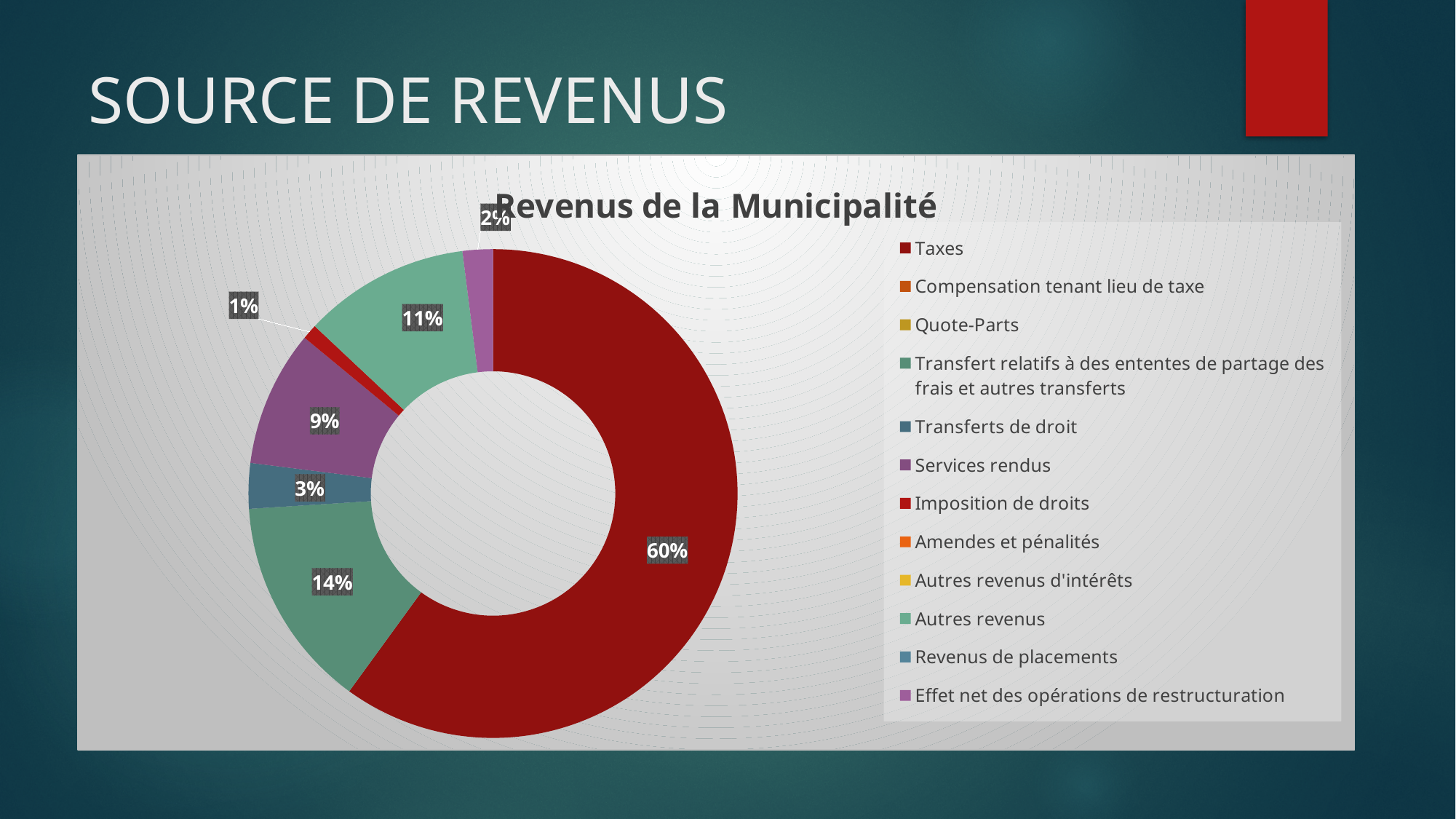
How many percentage points larger is the Taxes share than the Transfert relatifs à des ententes de partage des frais et autres transferts share? 46 percentage points How many entries does the legend of the Revenus de la Municipalité chart list? 12 What type of chart is shown on the slide? Doughnut (pie) chart What percentage is shown for Transferts de droit in the chart? 3% Which is larger in the chart: Services rendus or Autres revenus? Autres revenus What percentage is shown for Autres revenus in the chart? 11% What percentage of the Revenus de la Municipalité chart is Taxes? 60% Which revenue source has the largest share in the Revenus de la Municipalité chart? Taxes What share does Services rendus have in the Revenus de la Municipalité chart? 9% What percentage is shown for Transfert relatifs à des ententes de partage des frais et autres transferts? 14% What percentage is shown for Effet net des opérations de restructuration? 2% Which labelled slice has the smallest share in the chart? Imposition de droits (1%)